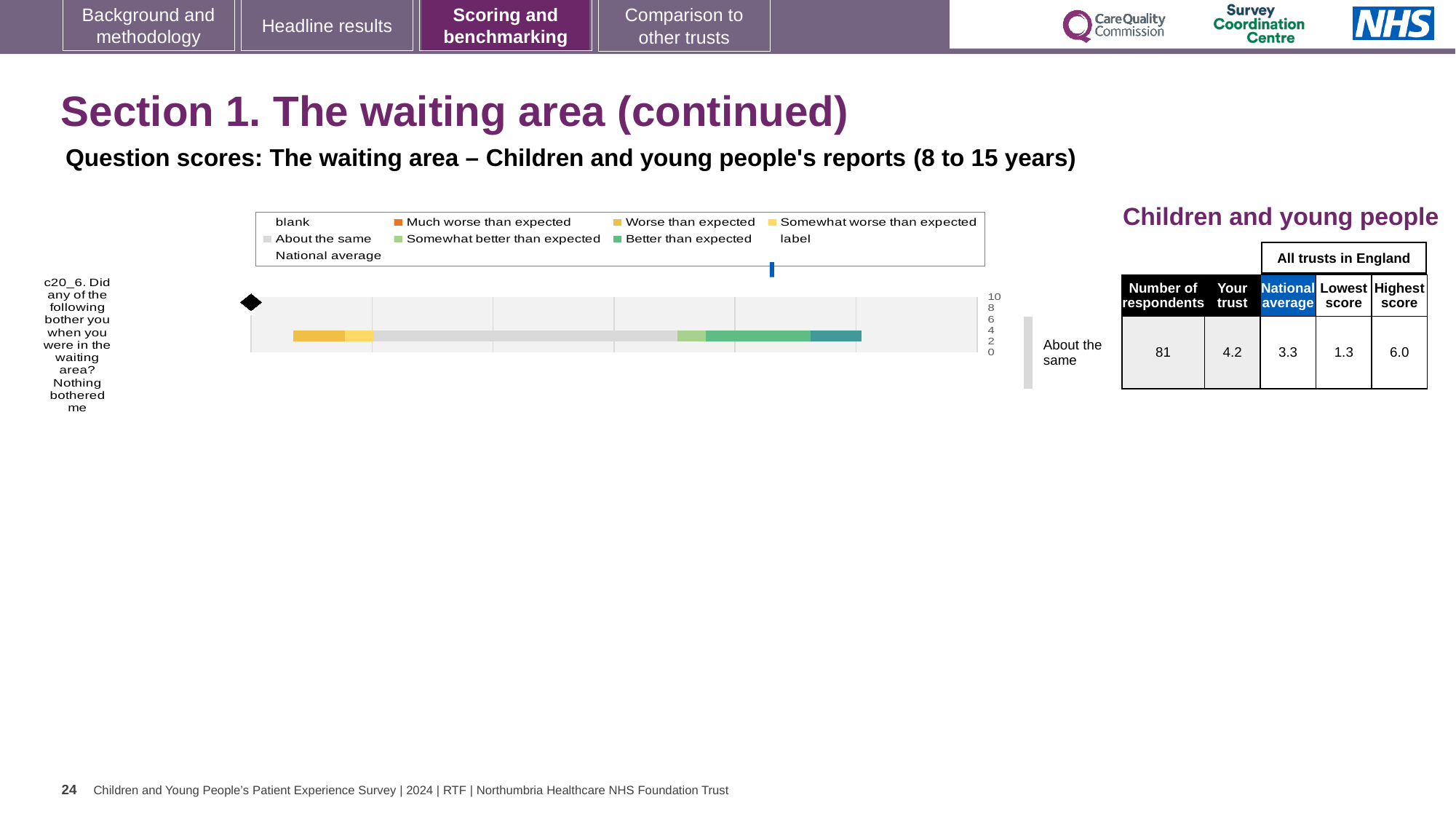
In the table beside the chart, what is the 'Your trust' score for question c20_6? 4.2 How many entries does the chart's legend list? 9 In the table beside the chart, what is the number of respondents for question c20_6? 81 In the table beside the chart, which is larger for question c20_6: the 'Your trust' score or the national average? Your trust In the table beside the chart, what is the lowest score among all trusts in England? 1.3 In the table beside the chart, what is the highest score among all trusts in England? 6.0 In the table beside the chart, what is the national average score for question c20_6? 3.3 What is the highest value shown on the chart's axis? 10 What colour does the legend use for 'Much worse than expected'? orange How many survey questions are plotted in the chart? 1 What kind of chart is shown on the slide? bar chart Which benchmark category label is shown next to the chart for question c20_6? About the same